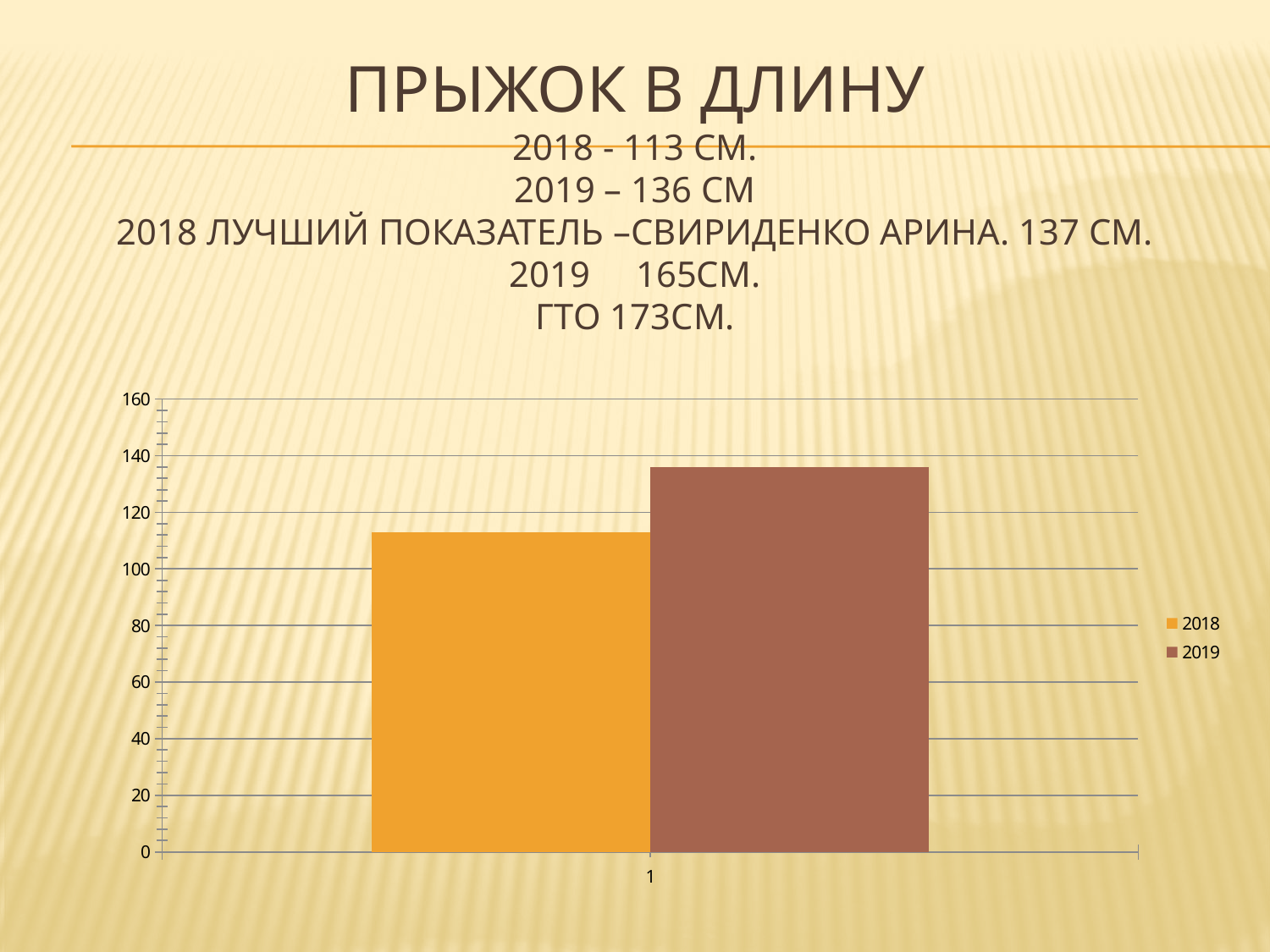
What are the entries listed in the chart legend? 2018, 2019 Is the value for 2018 greater or less than 120? less Is the value for 2018 greater or less than 100? greater According to the slide text, what is the long jump result for 2018? 113 см Which series has the taller bar, 2018 or 2019? 2019 What colour is the bar for the 2018 series? orange How many categories are shown on the x axis of the chart? 1 Is the value for 2019 greater or less than 140? less How many series does the chart legend list? 2 Which series has the lowest bar in the chart? 2018 What kind of chart is shown on the slide? bar chart